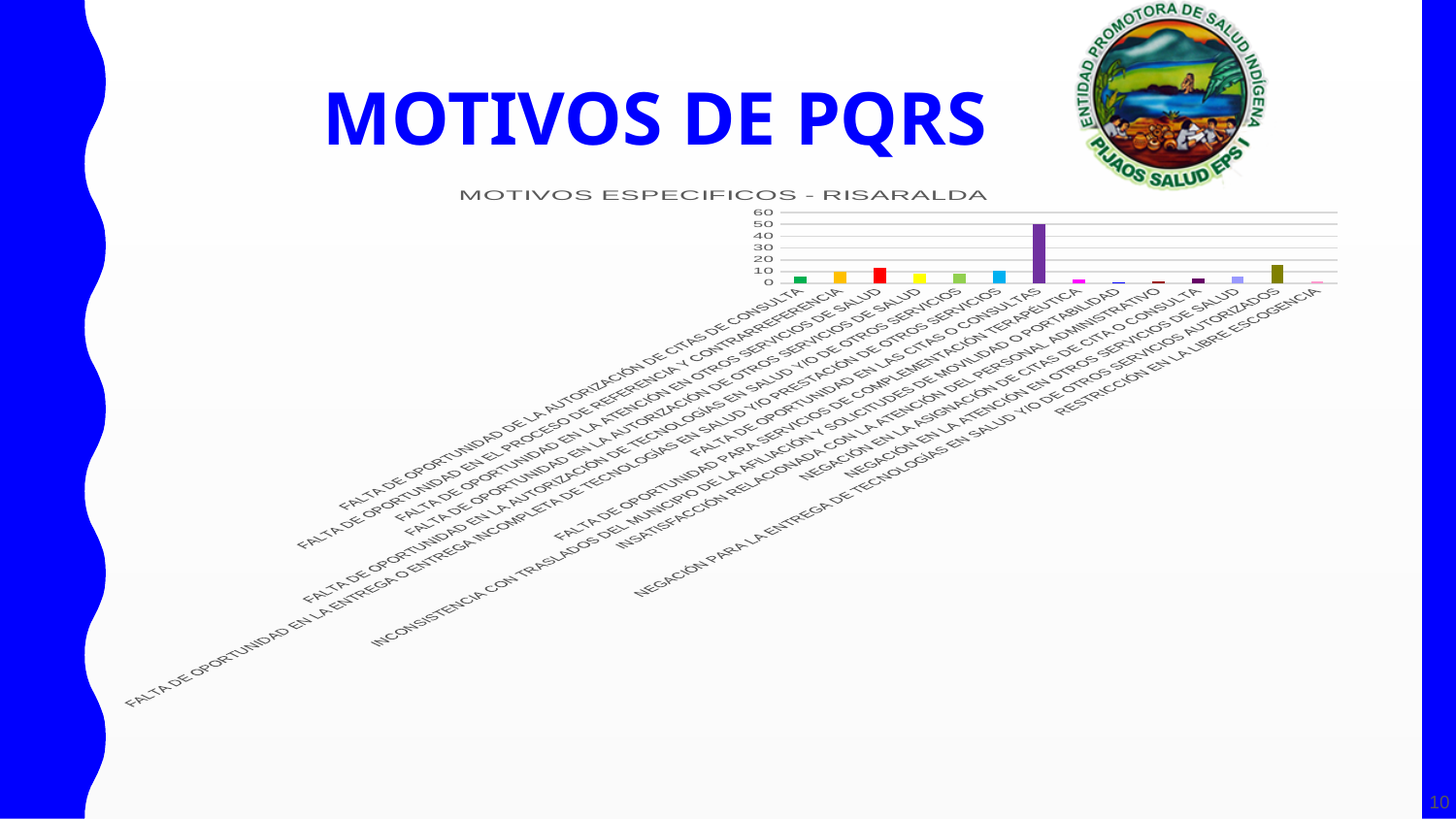
Is the value of the tallest bar in the chart greater or less than 60? less Is the value for NEGACIÓN PARA LA ENTREGA DE TECNOLOGÍAS EN SALUD Y/O DE OTROS SERVICIOS AUTORIZADOS greater or less than 10? greater Is the value for FALTA DE OPORTUNIDAD DE LA AUTORIZACIÓN DE CITAS DE CONSULTA greater or less than 20? less What is the highest value shown on the vertical axis of the chart? 60 What kind of chart is shown on the slide? bar chart What is the title of the chart? MOTIVOS ESPECIFICOS - RISARALDA